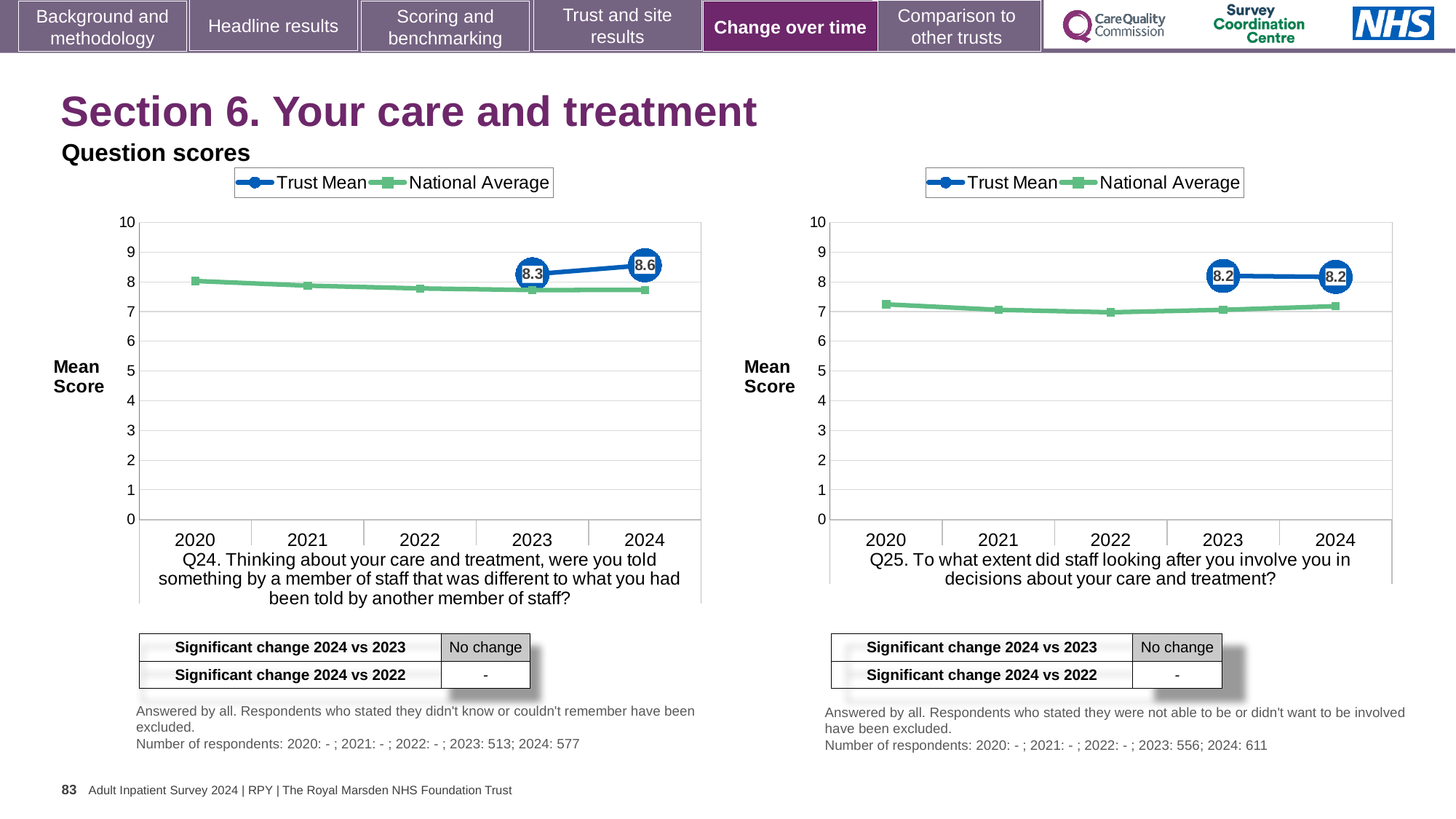
In the Q24 chart (left), does the Trust Mean rise or fall from 2023 to 2024? Rise In the Q25 chart (right), is the National Average for 2022 greater or less than 8? less How many series does the legend of the Q24 chart (left) list? 2 In the Q24 chart (left), what is the Trust Mean score for 2024? 8.6 In the Q24 chart (left), by how much did the Trust Mean change from 2023 to 2024? 0.3 In the Q24 chart (left), is the National Average for 2020 greater or less than 9? less How many years are shown on the x axis of the Q25 chart (right)? 5 In the Q24 chart (left), which is higher in 2024, the Trust Mean or the National Average? Trust Mean In the Q24 chart (left), what is the Trust Mean score for 2023? 8.3 In the Q25 chart (right), what is the Trust Mean score for 2023? 8.2 What is the y-axis label on the Q24 chart (left)? Mean Score What type of chart is used for Q25 (right)? Line chart